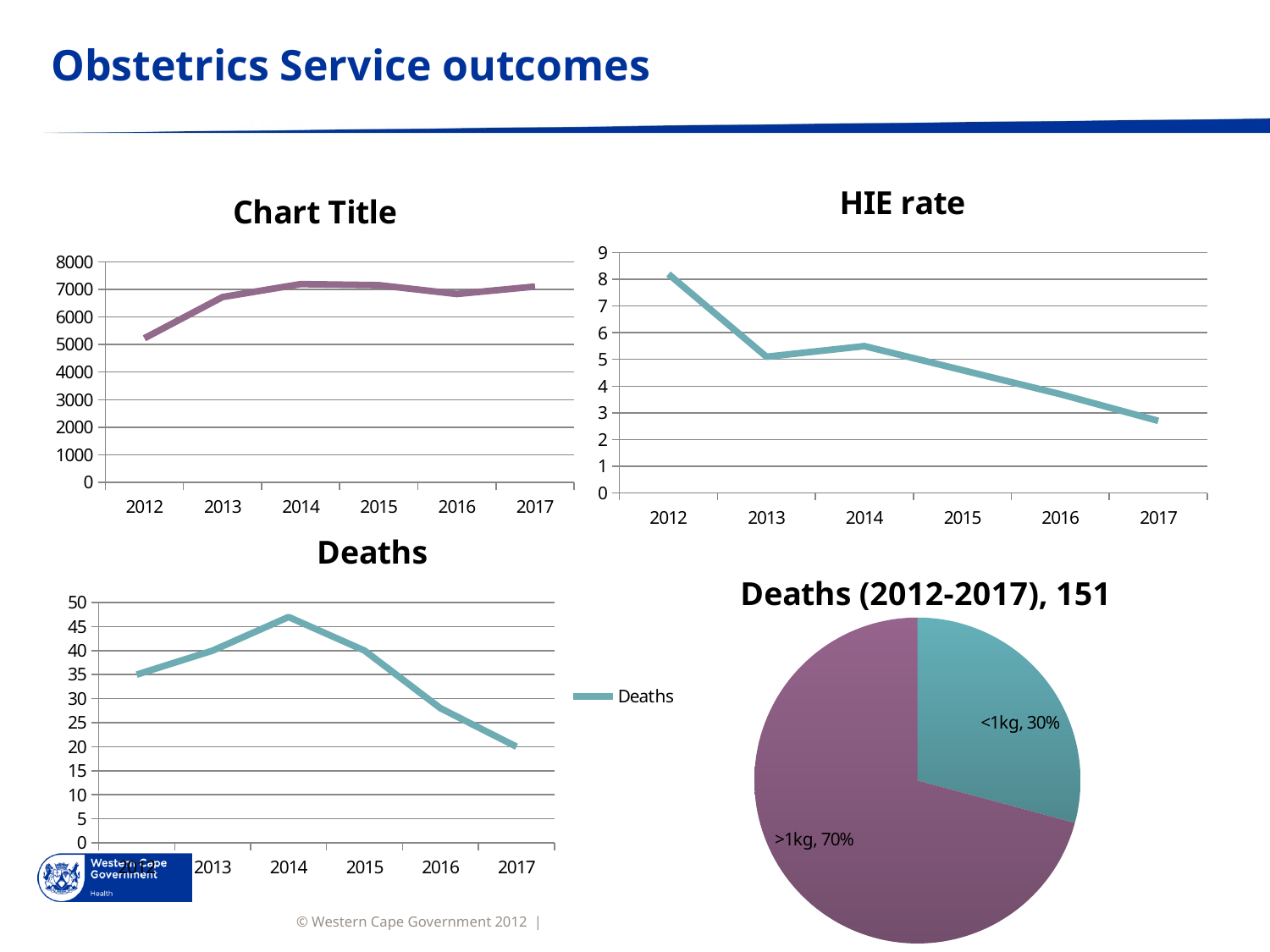
In the 'Deaths' line chart, which year has the lowest number of deaths? 2017 In the 'Deaths' line chart, is the value for 2017 greater or less than 25? less In the 'HIE rate' chart, do the values generally rise or fall from 2012 to 2017? fall In the 'HIE rate' chart, which year has the lowest HIE rate? 2017 In the chart titled 'Chart Title' at the top left, which year has the lowest value? 2012 In the 'Deaths' line chart, which year has the highest number of deaths? 2014 How many series does the legend of the 'Deaths' line chart list? 1 In the pie chart 'Deaths (2012-2017), 151', which slice is larger, <1kg or >1kg? >1kg In the 'HIE rate' chart, is the value for 2017 greater or less than 3? less In the 'HIE rate' chart, which year has the highest HIE rate? 2012 In the pie chart 'Deaths (2012-2017), 151', what share of deaths is in the <1kg category? 30% In the chart titled 'Chart Title' at the top left, is the value for 2012 greater or less than 6000? less